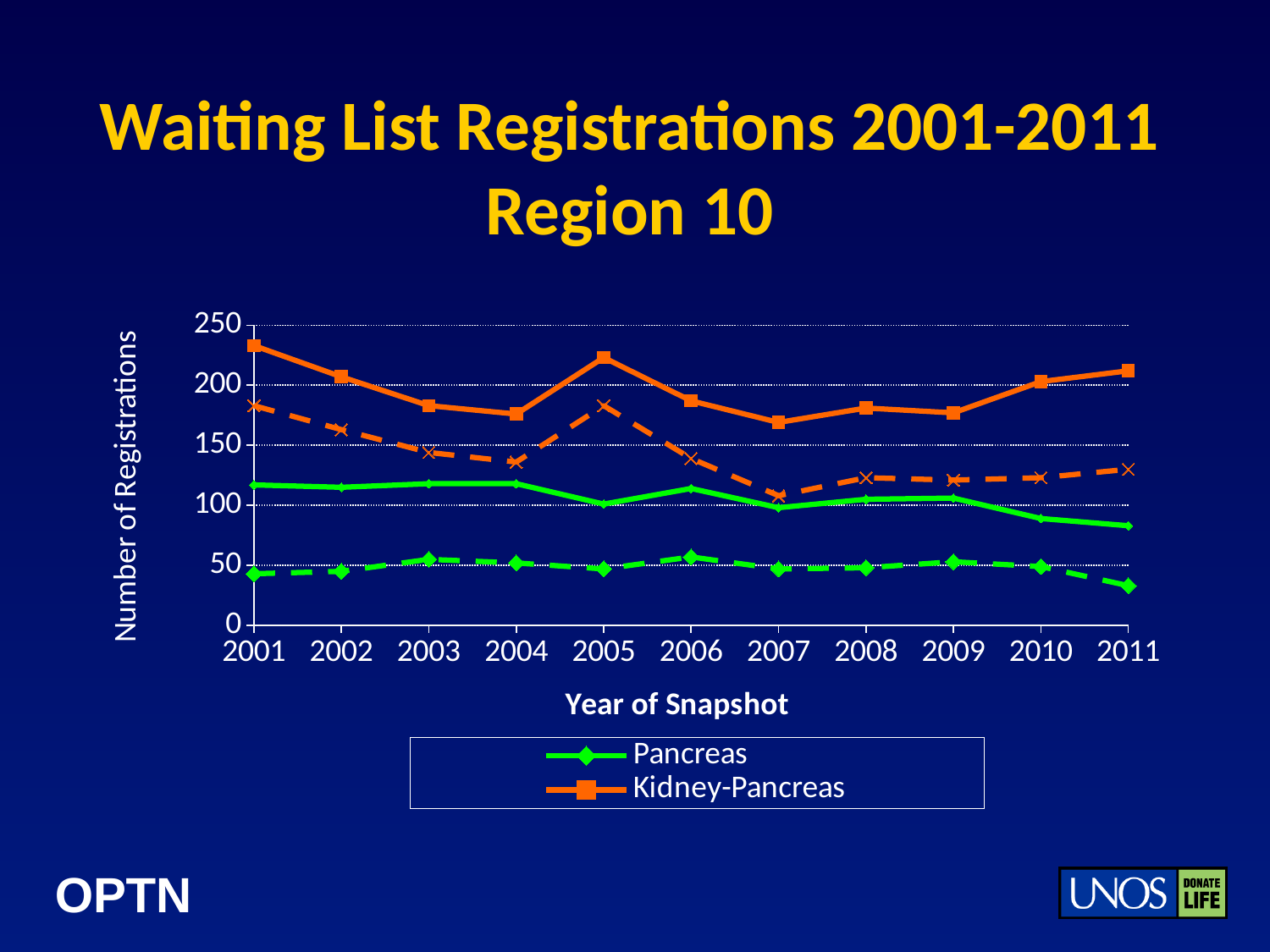
In which year is the Kidney-Pancreas line at its highest? 2001 Which is larger for Kidney-Pancreas: the value in 2001 or the value in 2011? 2001 What kind of chart is shown on the slide? Line chart Is the Pancreas value in 2001 greater or less than 100? greater In which year is the Pancreas line at its lowest? 2011 Is the Kidney-Pancreas value in 2007 greater or less than 200? less How many series does the legend list? 2 Is the Kidney-Pancreas value in 2001 greater or less than 200? greater What is the label on the y axis? Number of Registrations How many years are shown along the x axis? 11 Does the Pancreas line rise or fall overall from 2001 to 2011? Fall